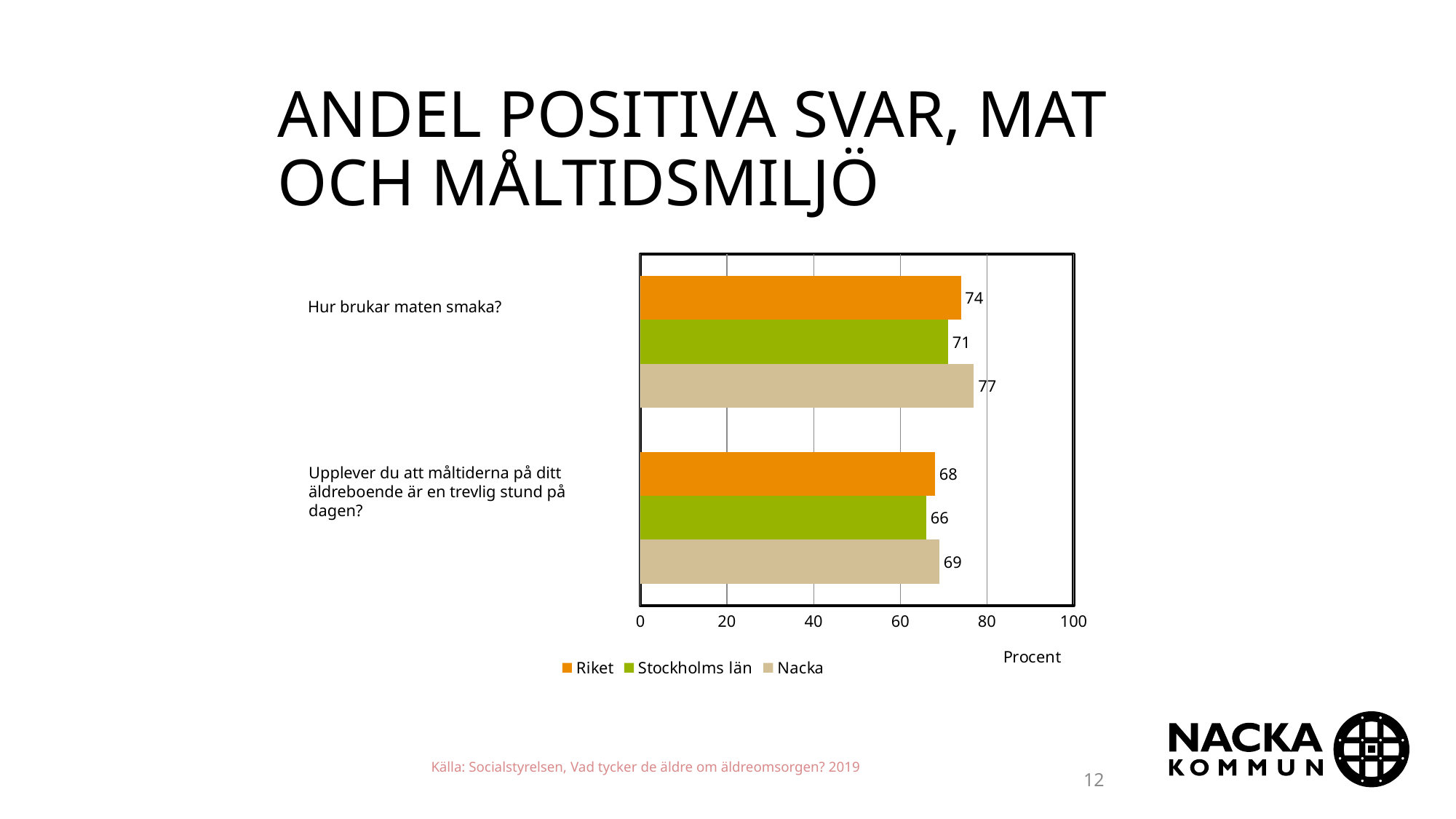
What kind of chart is shown on the slide? Bar chart What is the value for Stockholms län for "Upplever du att måltiderna på ditt äldreboende är en trevlig stund på dagen?"? 66 How many series does the legend list? 3 Which series has the highest value for "Hur brukar maten smaka?"? Nacka What is the difference between the Nacka and Stockholms län values for "Hur brukar maten smaka?"? 6 What is the value for Nacka for "Upplever du att måltiderna på ditt äldreboende är en trevlig stund på dagen?"? 69 What is the difference between the Riket values for the two questions? 6 Which series has the lowest value for "Upplever du att måltiderna på ditt äldreboende är en trevlig stund på dagen?"? Stockholms län Which is larger for Riket: the value for "Hur brukar maten smaka?" or for "Upplever du att måltiderna på ditt äldreboende är en trevlig stund på dagen?"? Hur brukar maten smaka? What is the value for Riket for "Hur brukar maten smaka?"? 74 What is the value for Nacka for "Hur brukar maten smaka?"? 77 What is the label on the horizontal axis of the chart? Procent